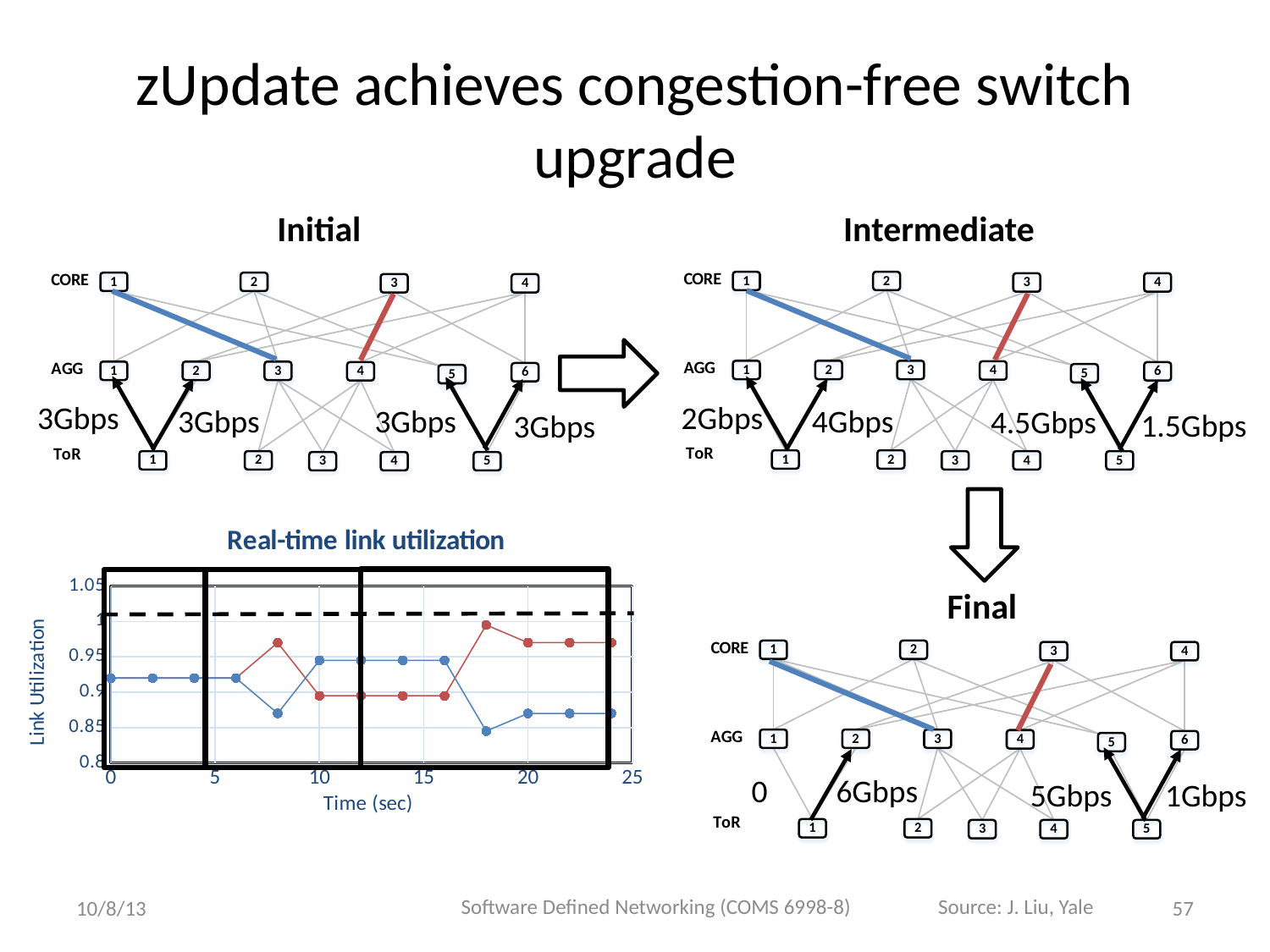
In the "Real-time link utilization" chart, is the blue line's value at 12 seconds greater or less than 0.9? greater In the "Real-time link utilization" chart, does the red line rise or fall between 16 and 18 seconds? rise What is the label of the x axis of the "Real-time link utilization" chart? Time (sec) In the "Real-time link utilization" chart, is the red line's value at 8 seconds greater or less than 0.95? greater What kind of chart is the "Real-time link utilization" chart? line chart In the "Real-time link utilization" chart, which line has the higher value at 8 seconds, the red or the blue? red In the "Real-time link utilization" chart, does the blue line rise or fall between 16 and 18 seconds? fall In the "Real-time link utilization" chart, which line has the higher value at 12 seconds, the red or the blue? blue In the "Real-time link utilization" chart, how many lines (series) are plotted? 2 In the "Real-time link utilization" chart, is the blue line's value at 8 seconds greater or less than 0.9? less What is the title of the chart on the slide? Real-time link utilization